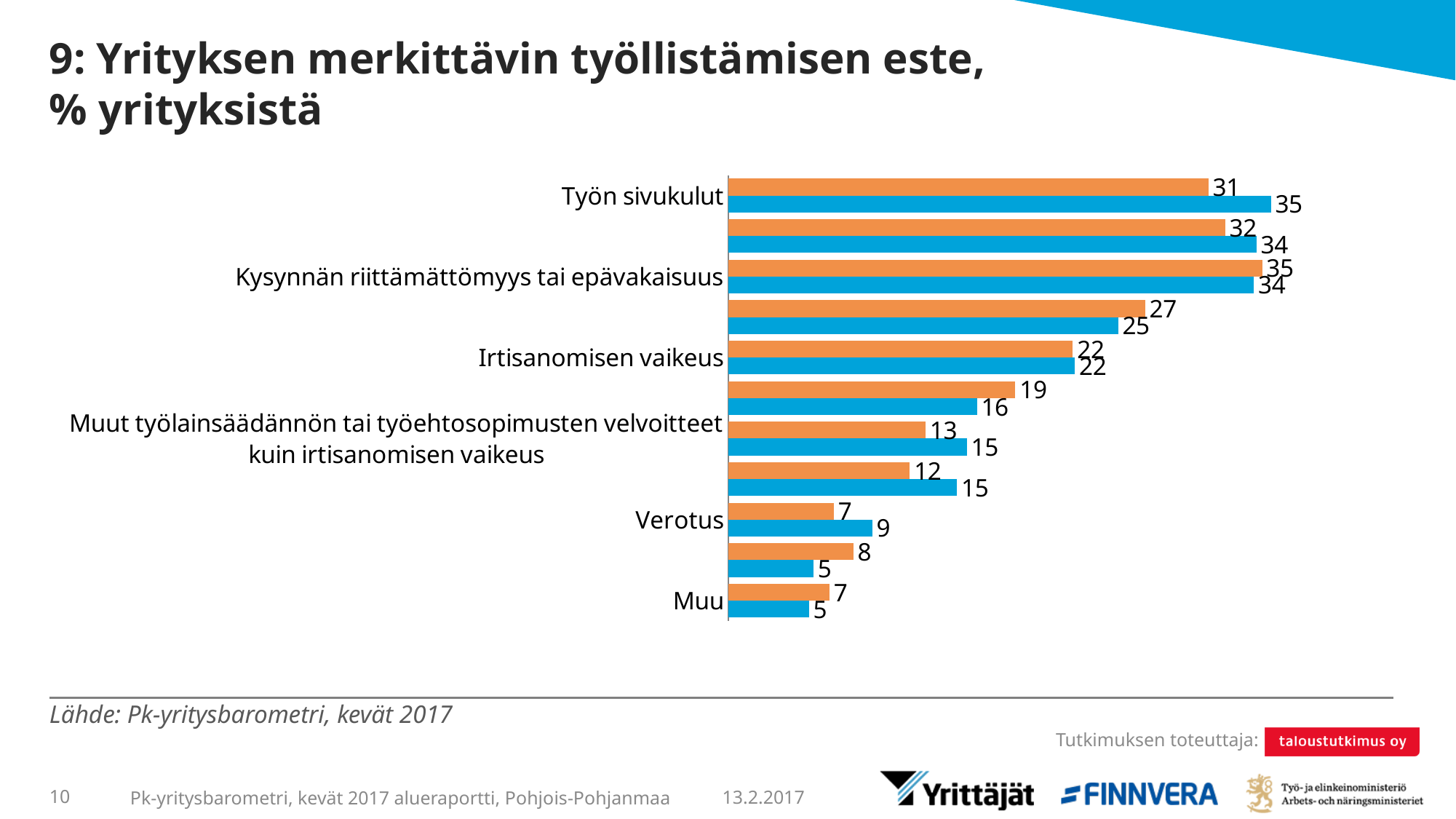
What is the value of the orange bar for Muu? 7 For Verotus, which bar is larger, the orange or the blue one? blue What kind of chart is shown on the slide? bar chart For Kysynnän riittämättömyys tai epävakaisuus, what is the difference between the orange bar and the blue bar? 1 How many pairs of bars (categories) are plotted in the chart? 11 For Työn sivukulut, how much larger is the blue bar than the orange bar? 4 What is the value of the blue bar for Työn sivukulut? 35 For Muu, which bar is larger, the orange or the blue one? orange What is the value of the orange bar for Kysynnän riittämättömyys tai epävakaisuus? 35 What is the value of the blue bar for Irtisanomisen vaikeus? 22 What is the value of the orange bar for Työn sivukulut? 31 What is the value of the blue bar for Verotus? 9